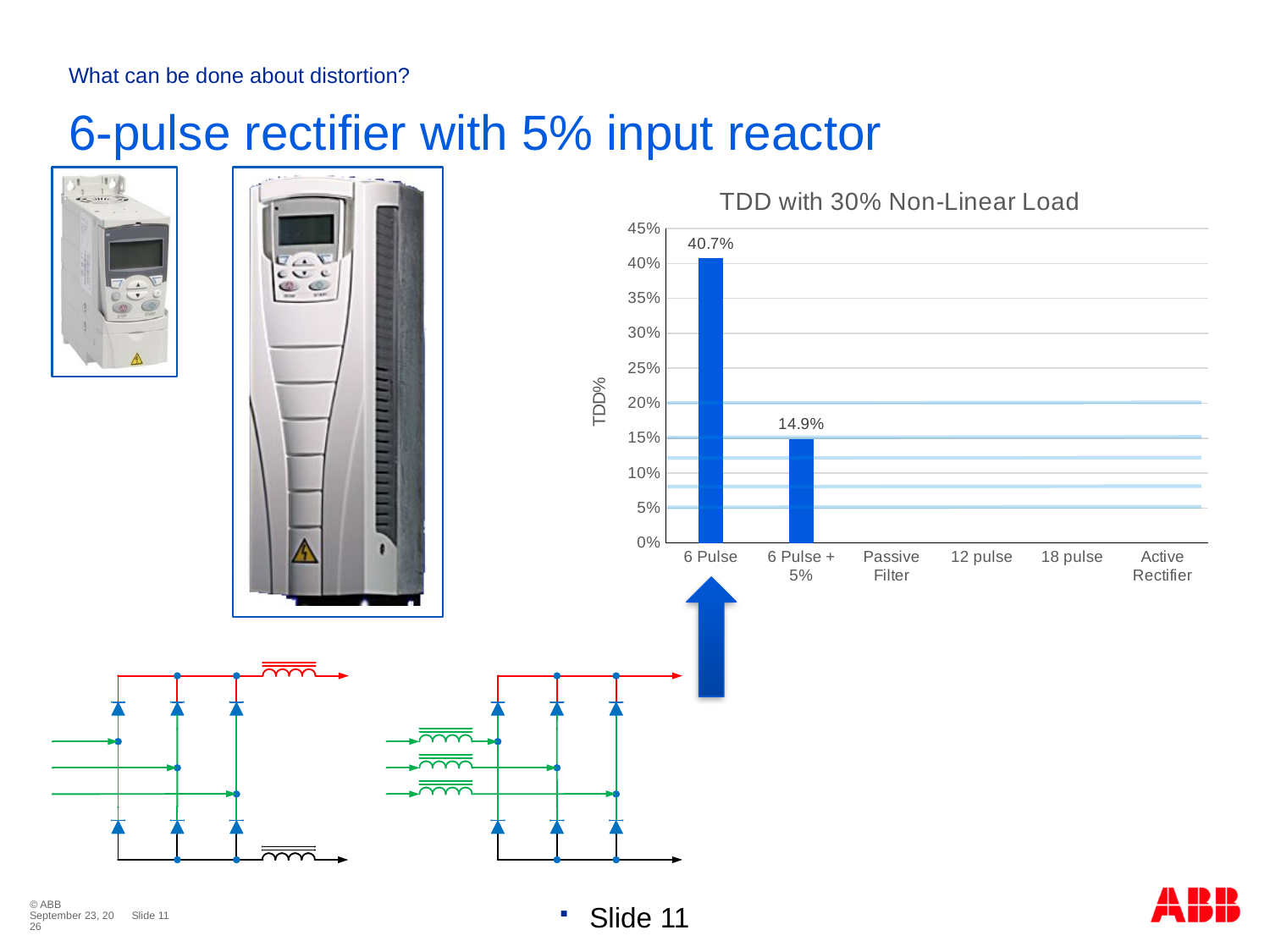
Which is larger, the TDD value for 6 Pulse or for 6 Pulse + 5%? 6 Pulse Is the TDD value for 6 Pulse + 5% greater or less than 20%? less What is the difference between the TDD values for 6 Pulse and 6 Pulse + 5%? 25.8% How many categories are listed on the x axis of the chart? 6 Is the TDD value for 6 Pulse greater or less than 35%? greater What is the label of the y axis of the chart? TDD% Which category has the highest plotted TDD value? 6 Pulse What is the TDD value for 6 Pulse? 40.7% How many categories have a bar plotted in the chart? 2 What is the TDD value for 6 Pulse + 5%? 14.9% What is the title of the chart? TDD with 30% Non-Linear Load What kind of chart is shown on the slide? bar chart